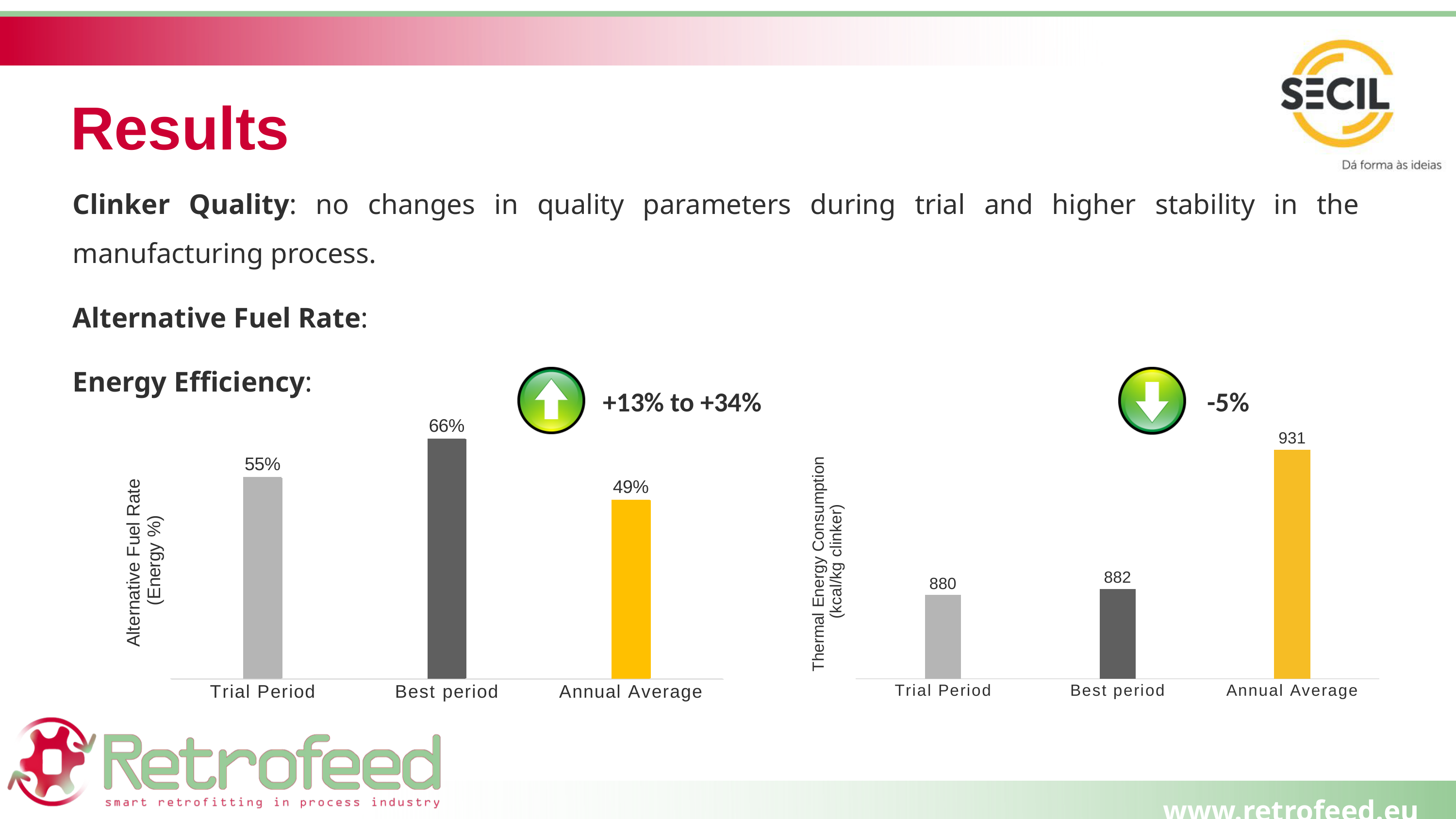
In the right chart (Thermal Energy Consumption), what is the value for Trial Period? 880 In the right chart (Thermal Energy Consumption), which category has the highest value? Annual Average In the right chart (Thermal Energy Consumption), is the value for Annual Average larger or smaller than the value for Best period? larger In the left chart (Alternative Fuel Rate), which category has the lowest value? Annual Average In the right chart (Thermal Energy Consumption), what is the difference between the Annual Average and Trial Period values? 51 What kind of chart is the right chart (Thermal Energy Consumption)? bar chart In the right chart (Thermal Energy Consumption), what is the value for Annual Average? 931 In the left chart (Alternative Fuel Rate), which category has the highest value? Best period In the left chart (Alternative Fuel Rate), what is the difference between the Best period and Trial Period values? 11% In the left chart (Alternative Fuel Rate), what is the value for Annual Average? 49% In the left chart (Alternative Fuel Rate), what is the value for Best period? 66% How many categories are shown on the x axis of the left chart (Alternative Fuel Rate)? 3